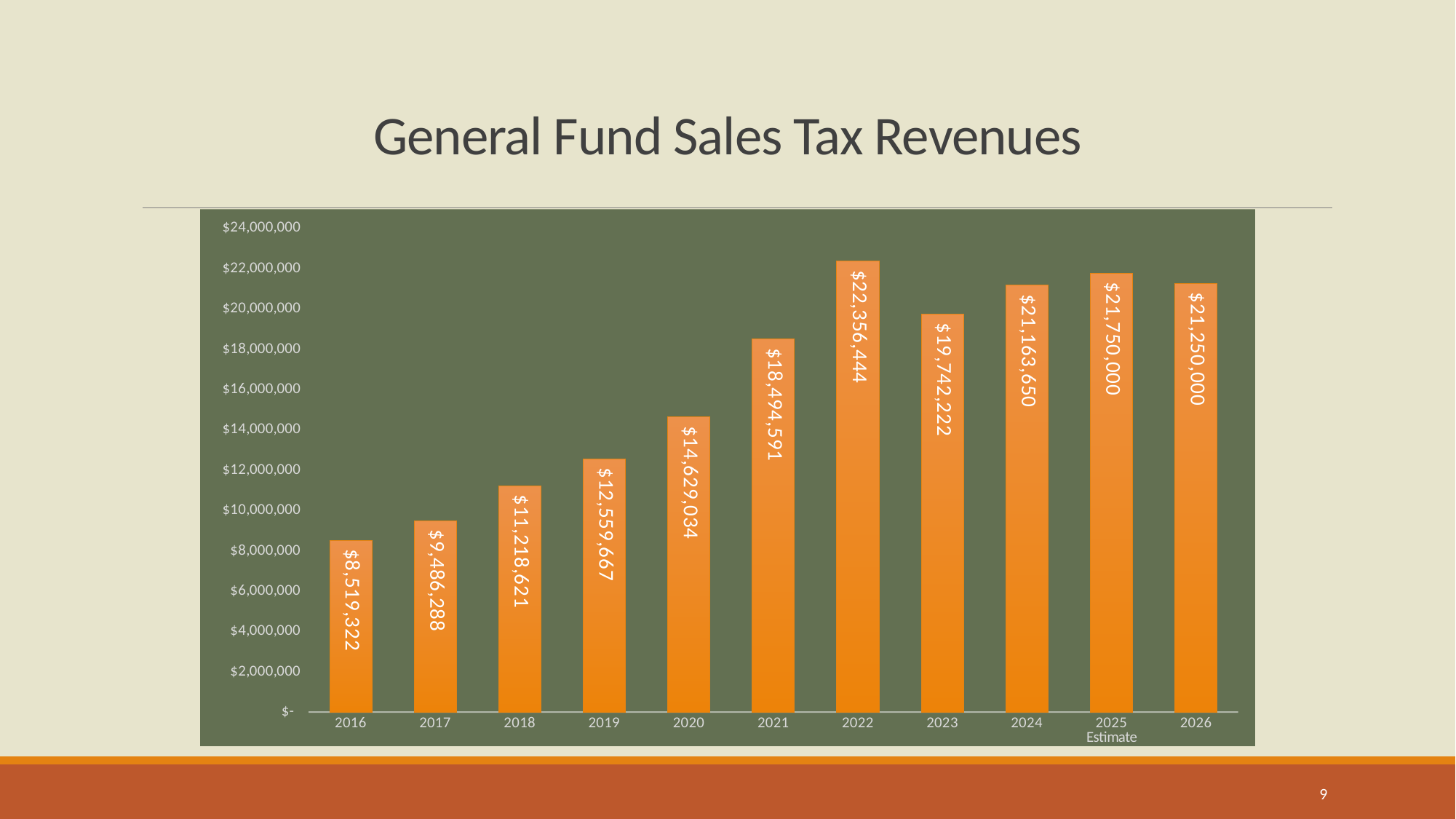
What kind of chart is shown on the slide? Bar chart Which year has the lowest General Fund Sales Tax Revenue? 2016 Which is larger, the revenue for 2023 or for 2024? 2024 What is the revenue value for 2018? $11,218,621 Is the value for 2019 greater or less than $12,000,000? greater By how much does the 2022 revenue exceed the 2021 revenue? $3,861,853 What is the General Fund Sales Tax Revenue for 2020? $14,629,034 How many years are shown on the chart? 11 How much higher is the 2025 Estimate than the 2026 value? $500,000 Do the revenues rise or fall from 2016 to 2022? Rise Which year has the highest General Fund Sales Tax Revenue? 2022 What is the value shown for the 2025 Estimate? $21,750,000